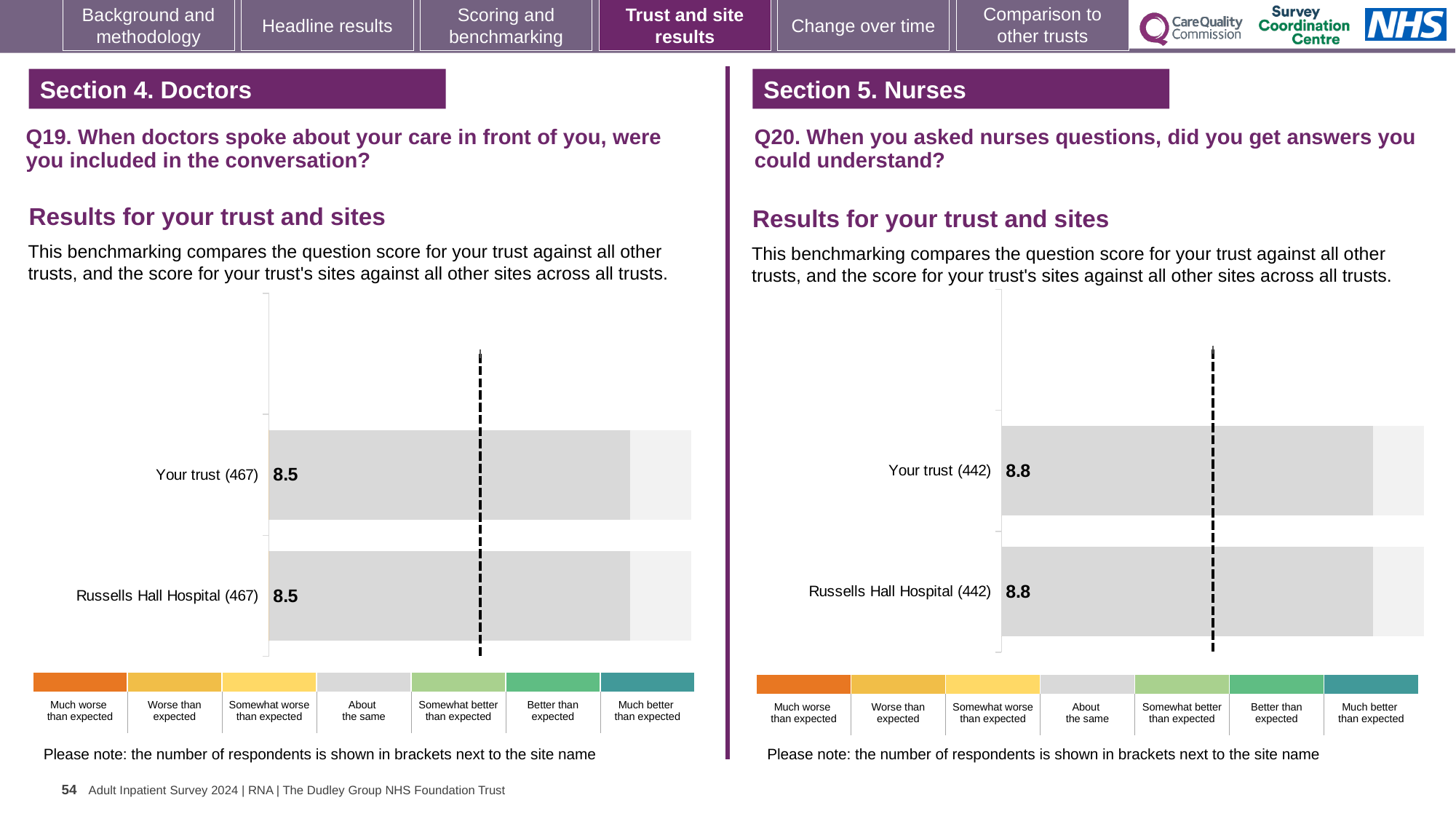
On the Q19 chart (left), how many respondents are shown in brackets next to Your trust? 467 What is the difference between the Your trust score on the Q20 chart (right) and the Your trust score on the Q19 chart (left)? 0.3 Which is larger: the Your trust score on the Q20 chart (right) or the Your trust score on the Q19 chart (left)? Q20 chart (right) What kind of chart is used on the Q19 chart (left)? Bar chart How many bars are plotted on the Q20 chart (right)? 2 On the Q20 chart (right), what is the score for Russells Hall Hospital? 8.8 On the Q20 chart (right), how many respondents are shown in brackets next to Russells Hall Hospital? 442 On the Q19 chart (left), what is the score for Your trust? 8.5 How many bars are plotted on the Q19 chart (left)? 2 On the Q19 chart (left), what is the score for Russells Hall Hospital? 8.5 How many benchmark categories does the colour legend below the Q19 chart (left) list? 7 On the Q20 chart (right), what is the score for Your trust? 8.8